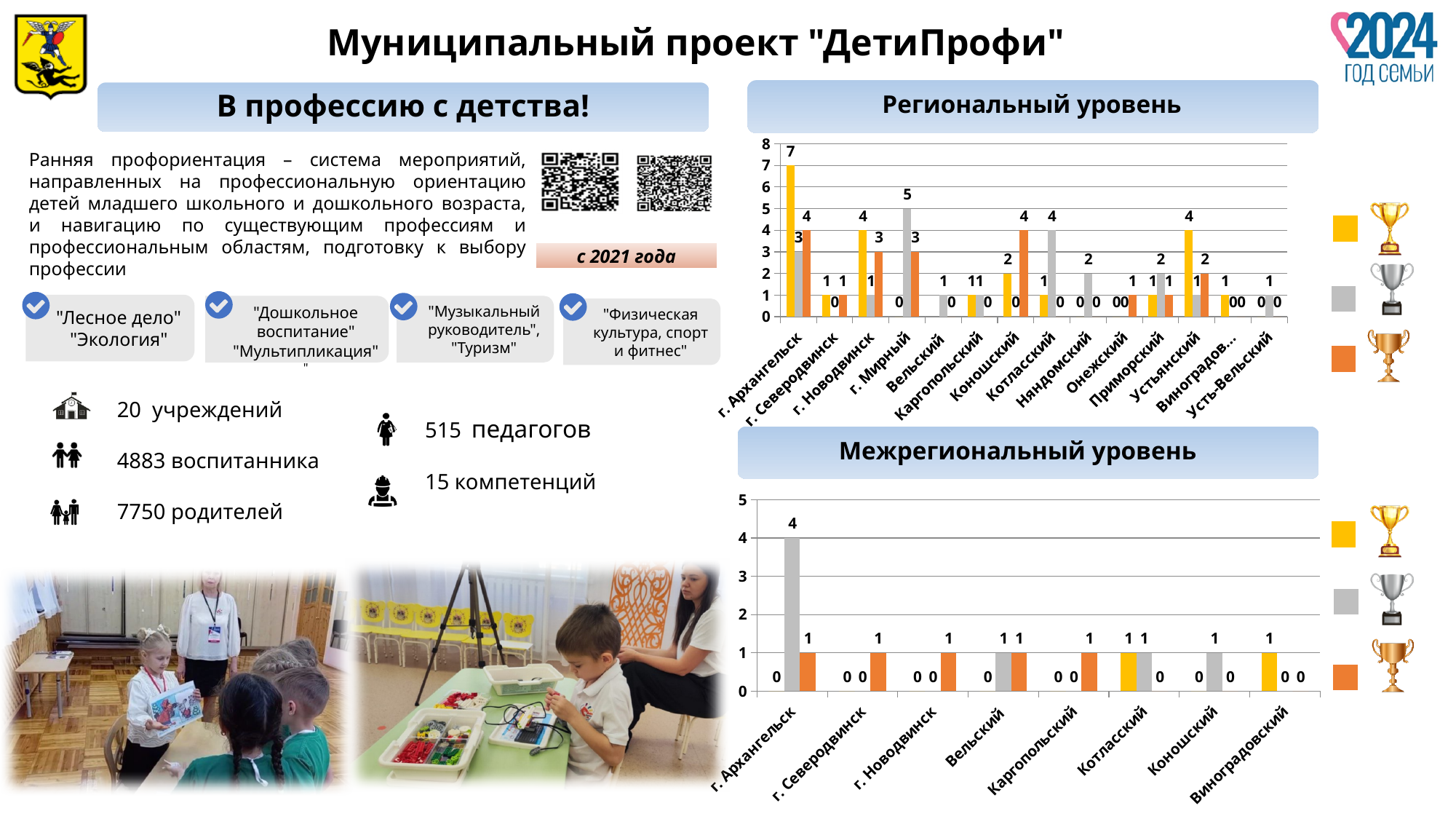
In the "Региональный уровень" chart, what is the value of the yellow bar for г. Архангельск? 7 In the "Межрегиональный уровень" chart, what is the total of the three bars for г. Архангельск? 5 In the "Региональный уровень" chart, what is the difference between the yellow bar for г. Архангельск and the yellow bar for г. Новодвинск? 3 In the "Региональный уровень" chart, which category has the highest gray bar? г. Мирный In the "Региональный уровень" chart, what is the value of the gray bar for г. Мирный? 5 What kind of chart is the "Региональный уровень" chart? bar chart In the "Межрегиональный уровень" chart, what is the value of the gray bar for г. Архангельск? 4 How many categories are shown on the x axis of the "Межрегиональный уровень" chart? 8 How many series does the legend of the "Межрегиональный уровень" chart show? 3 In the "Региональный уровень" chart, which is larger: the gray bar for Котласский or the gray bar for Няндомский? Котласский How many categories are shown on the x axis of the "Региональный уровень" chart? 14 In the "Региональный уровень" chart, which category has the highest yellow bar? г. Архангельск